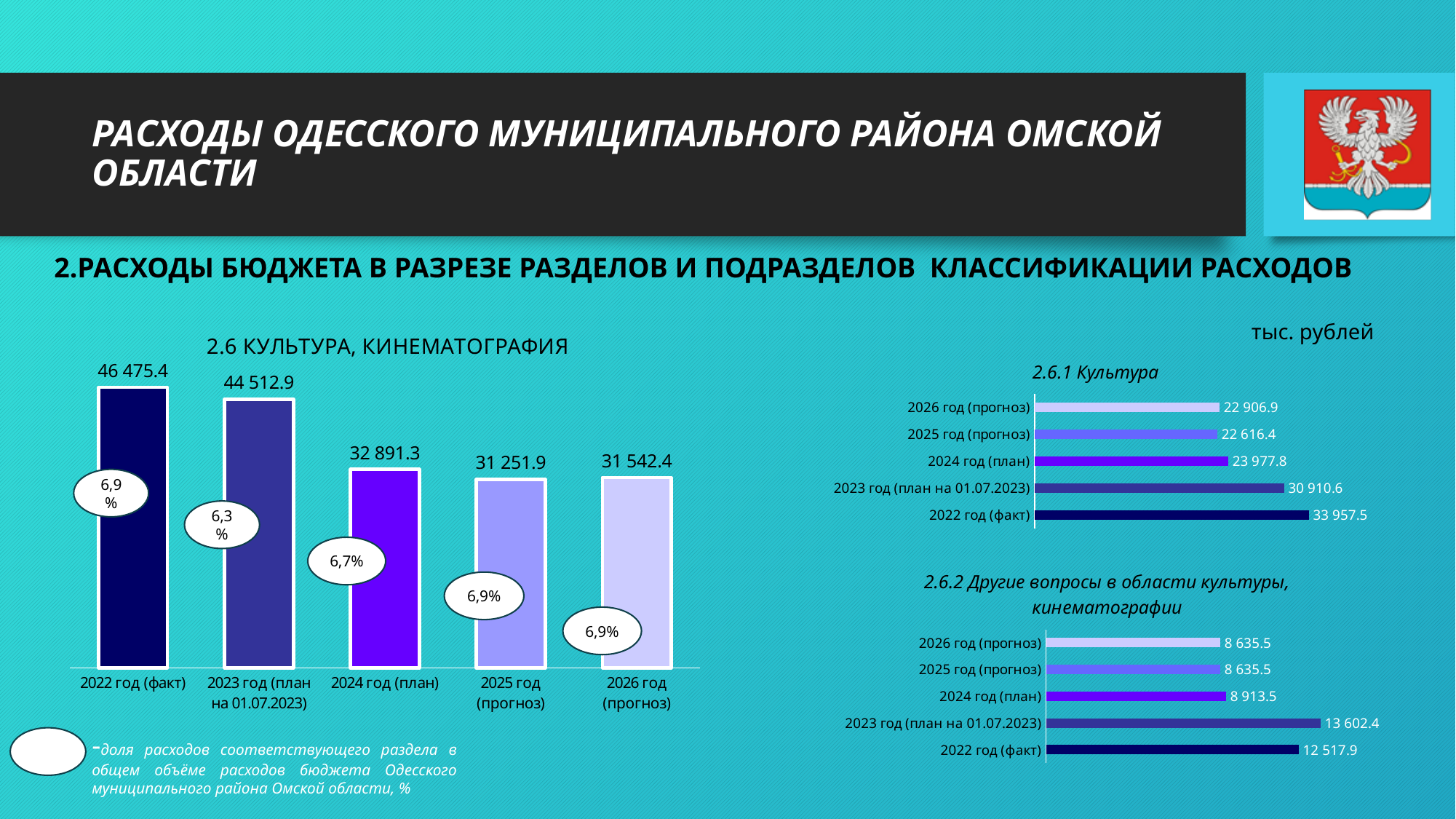
In the chart '2.6 КУЛЬТУРА, КИНЕМАТОГРАФИЯ', how many bars are plotted? 5 In the chart '2.6.1 Культура', what is the difference between the values for 2022 год (факт) and 2023 год (план на 01.07.2023)? 3 046.9 In the chart '2.6 КУЛЬТУРА, КИНЕМАТОГРАФИЯ', what share of total budget expenditure is shown in the oval for 2024 год (план)? 6,7% In the chart '2.6.2 Другие вопросы в области культуры, кинематографии', which is larger: the value for 2022 год (факт) or 2023 год (план на 01.07.2023)? 2023 год (план на 01.07.2023) In the chart '2.6 КУЛЬТУРА, КИНЕМАТОГРАФИЯ', what is the difference between the values for 2022 год (факт) and 2023 год (план на 01.07.2023)? 1 962.5 In the chart '2.6.1 Культура', what is the value for 2024 год (план)? 23 977.8 In the chart '2.6.1 Культура', which category has the highest value? 2022 год (факт) In the chart '2.6 КУЛЬТУРА, КИНЕМАТОГРАФИЯ', which category has the lowest value? 2025 год (прогноз) What type of chart is '2.6.1 Культура'? Bar chart In the chart '2.6 КУЛЬТУРА, КИНЕМАТОГРАФИЯ', what is the value for 2022 год (факт)? 46 475.4 In the chart '2.6.2 Другие вопросы в области культуры, кинематографии', what is the difference between the values for 2023 год (план на 01.07.2023) and 2022 год (факт)? 1 084.5 In the chart '2.6.2 Другие вопросы в области культуры, кинематографии', what is the value for 2023 год (план на 01.07.2023)? 13 602.4